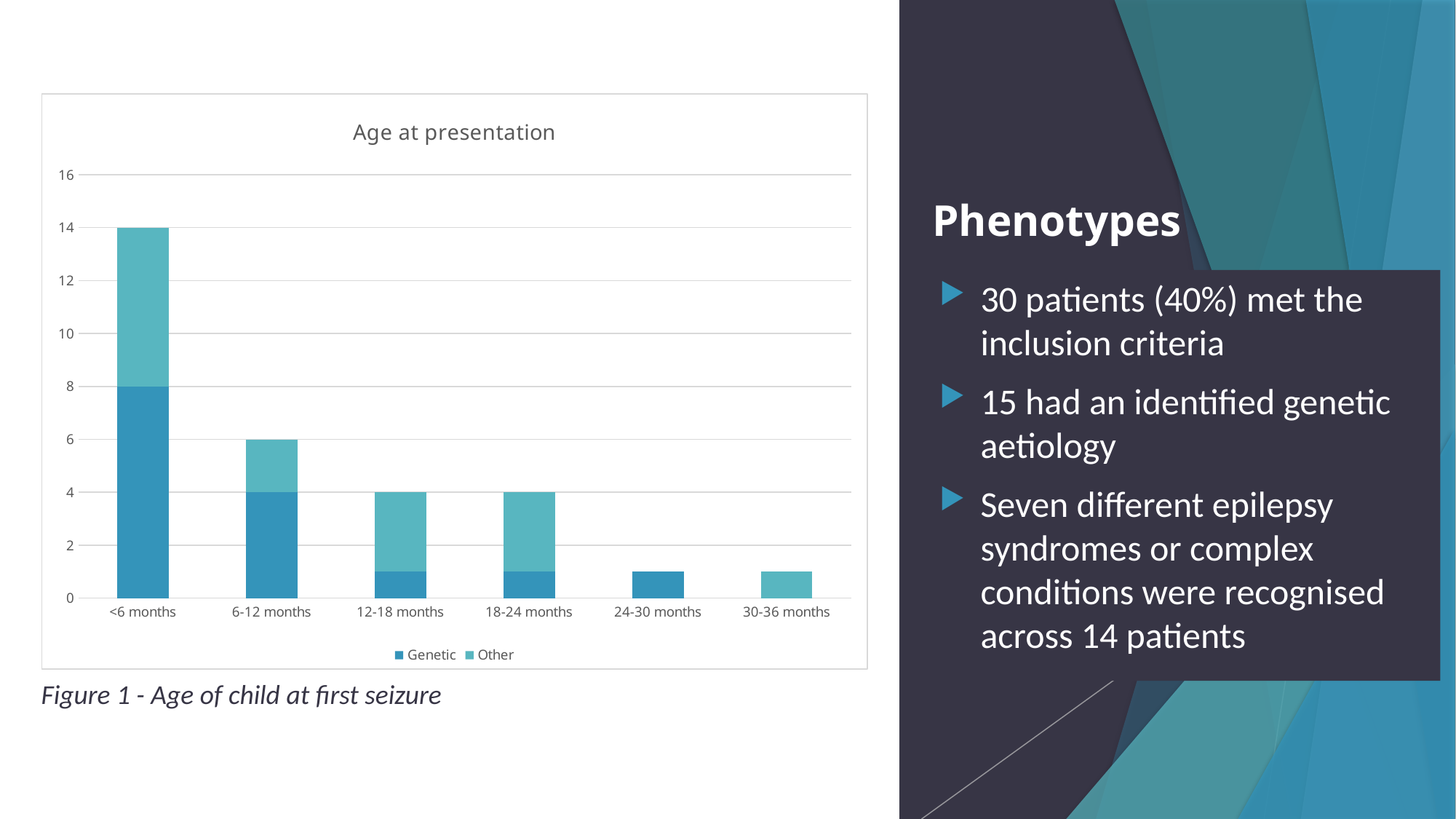
How many age categories are shown on the x axis? 6 What is the total height of the stacked bar for 6-12 months? 6 What is the total height of the stacked bar for <6 months? 14 Is the total value for 24-30 months greater or less than 2? less Do the total bar heights generally rise or fall from <6 months to 30-36 months? fall Which is larger, the total bar for 6-12 months or the total bar for 12-18 months? 6-12 months What type of chart is shown on the slide? stacked bar chart What is the Genetic value for 6-12 months? 4 Which age category has the highest total bar? <6 months How many series does the legend list? 2 What is the title of the chart? Age at presentation What is the Genetic value for <6 months? 8